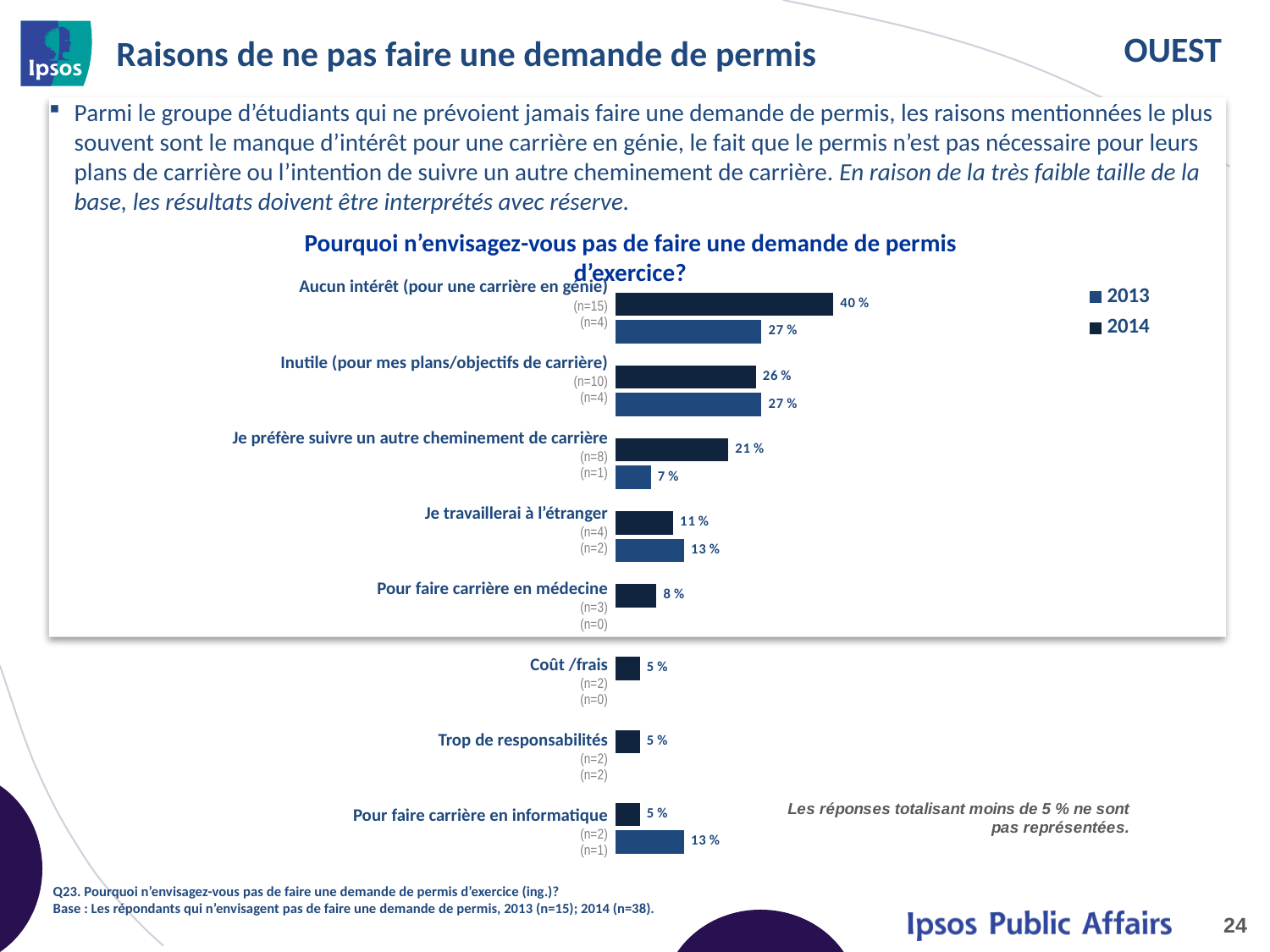
For "Je travaillerai à l'étranger", which year has the larger value, 2013 or 2014? 2013 For "Je préfère suivre un autre cheminement de carrière", which year has the larger value, 2013 or 2014? 2014 How many series does the legend list? 2 What is the difference between the 2013 and 2014 values for "Aucun intérêt (pour une carrière en génie)"? 13 % What are the two series named in the chart legend? 2013 and 2014 How many categories (reasons) are listed on the chart? 8 What is the 2014 value for "Pour faire carrière en informatique"? 5 % What is the 2013 value for "Aucun intérêt (pour une carrière en génie)"? 27 % What is the 2014 value for "Je préfère suivre un autre cheminement de carrière"? 21 % What kind of chart is shown on the slide? Bar chart